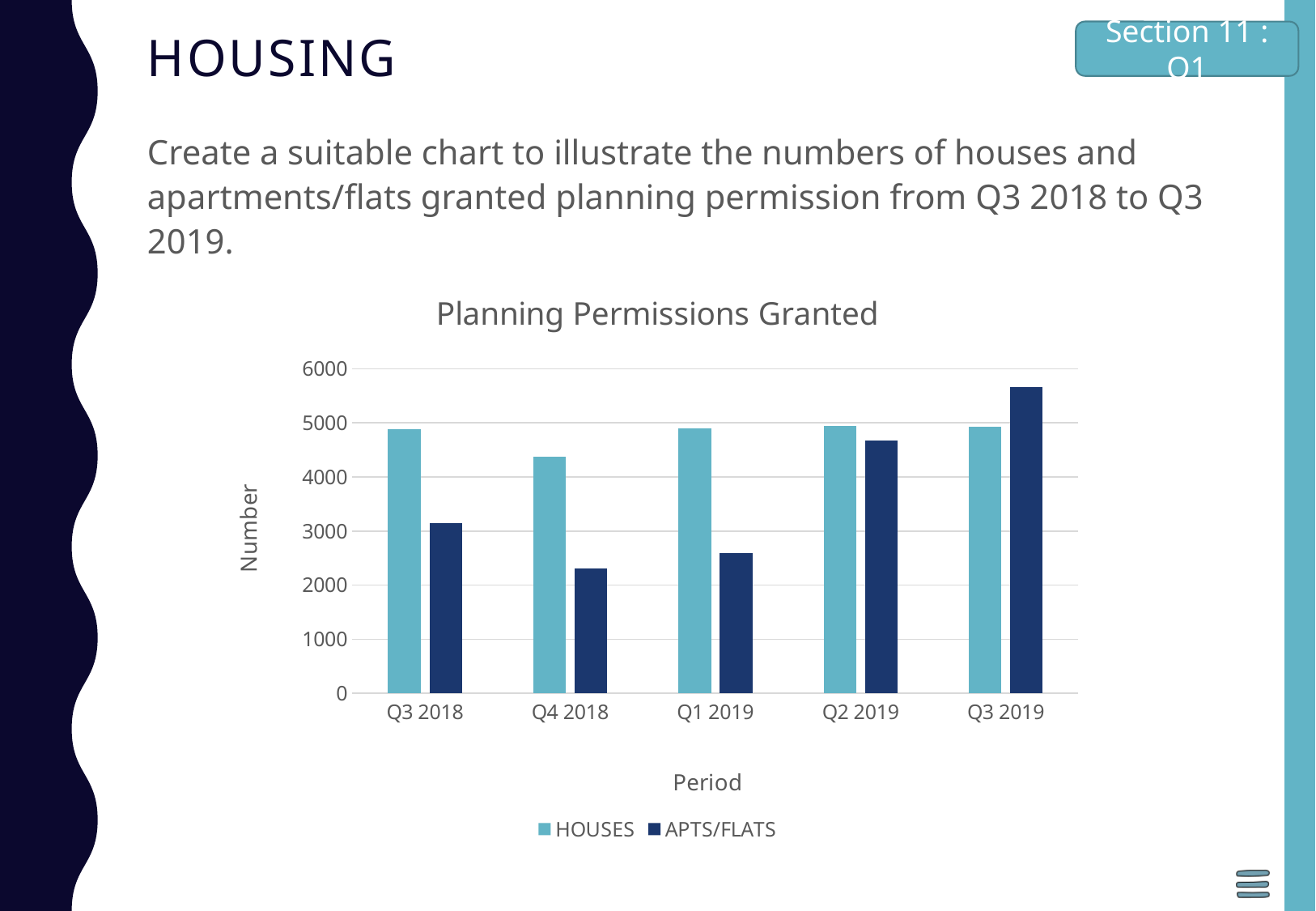
What kind of chart is shown on the slide? bar chart In which period is the APTS/FLATS value highest? Q3 2019 Is the APTS/FLATS value for Q1 2019 greater or less than 3000? less In Q3 2019, which is larger: HOUSES or APTS/FLATS? APTS/FLATS In Q3 2018, which is larger: HOUSES or APTS/FLATS? HOUSES How many periods are shown on the x axis of the chart? 5 What is the title of the chart? Planning Permissions Granted How many series does the legend of the Planning Permissions Granted chart list? 2 Is the HOUSES value for Q4 2018 greater or less than 5000? less In which period is the APTS/FLATS value lowest? Q4 2018 Is the APTS/FLATS value for Q3 2019 greater or less than 5000? greater In which period is the HOUSES value lowest? Q4 2018